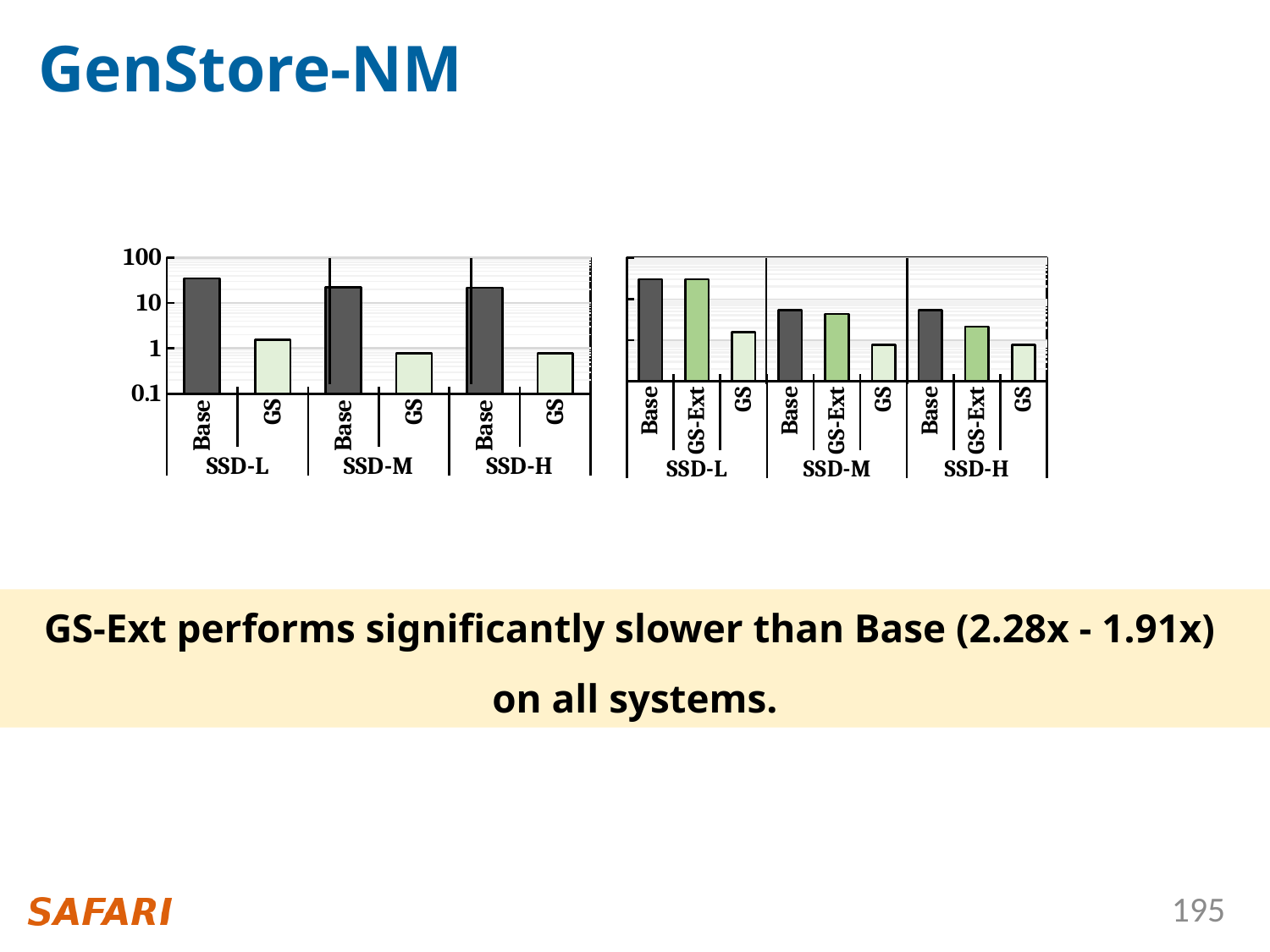
In the left chart, which is larger in the SSD-L group, Base or GS? Base In the right chart, which is larger in the SSD-H group, GS-Ext or GS? GS-Ext In the left chart, is the value for Base in the SSD-L group greater or less than 10? greater In the right chart, which is larger in the SSD-M group, Base or GS? Base In the left chart, how many SSD groups are shown on the x axis? 3 In the left chart, is the value for Base in the SSD-H group greater or less than 100? less What kind of chart is the left chart on the slide? bar chart In the left chart, is the value for GS in the SSD-L group greater or less than 1? greater In the left chart, which SSD group has the highest Base bar? SSD-L Which bar label appears in the right chart but not in the left chart? GS-Ext In the right chart, how many bars are there in each SSD group? 3